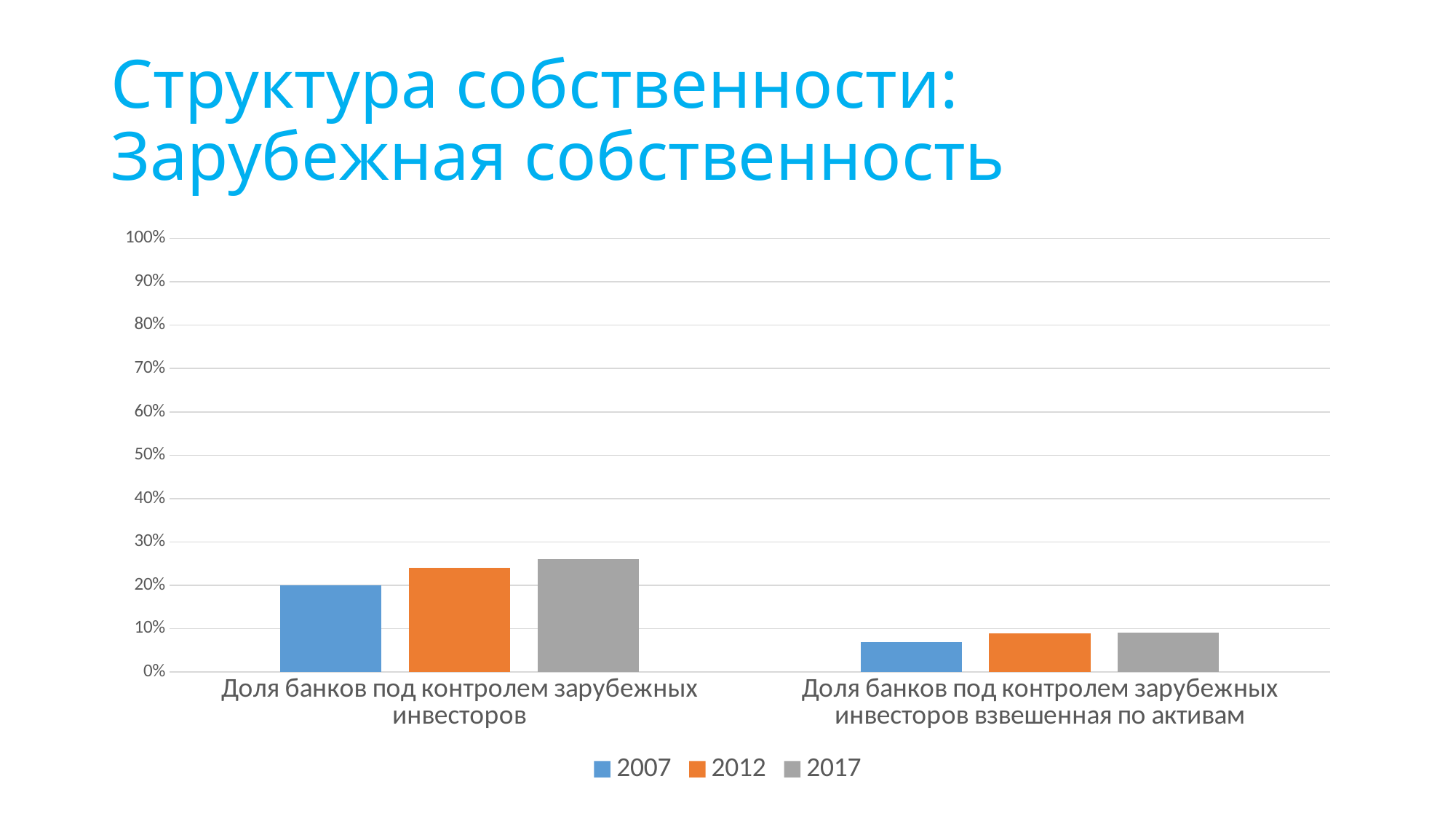
Which is larger: the 2012 value for 'Доля банков под контролем зарубежных инвесторов' or the 2012 value for 'Доля банков под контролем зарубежных инвесторов взвешенная по активам'? Доля банков под контролем зарубежных инвесторов Is the 2007 value for 'Доля банков под контролем зарубежных инвесторов взвешенная по активам' greater or less than 10%? less For the category 'Доля банков под контролем зарубежных инвесторов', which year has the highest value? 2017 How many categories are shown on the x axis? 2 For the category 'Доля банков под контролем зарубежных инвесторов', do the values rise or fall from 2007 to 2017? rise For the category 'Доля банков под контролем зарубежных инвесторов', which year has the lowest value? 2007 What is the title of the slide? Структура собственности: Зарубежная собственность What kind of chart is shown on the slide? bar chart Which years are listed in the legend? 2007, 2012, 2017 Is the 2007 value for 'Доля банков под контролем зарубежных инвесторов' greater or less than 30%? less Is the 2017 value for 'Доля банков под контролем зарубежных инвесторов' greater or less than 20%? greater How many series does the legend list? 3